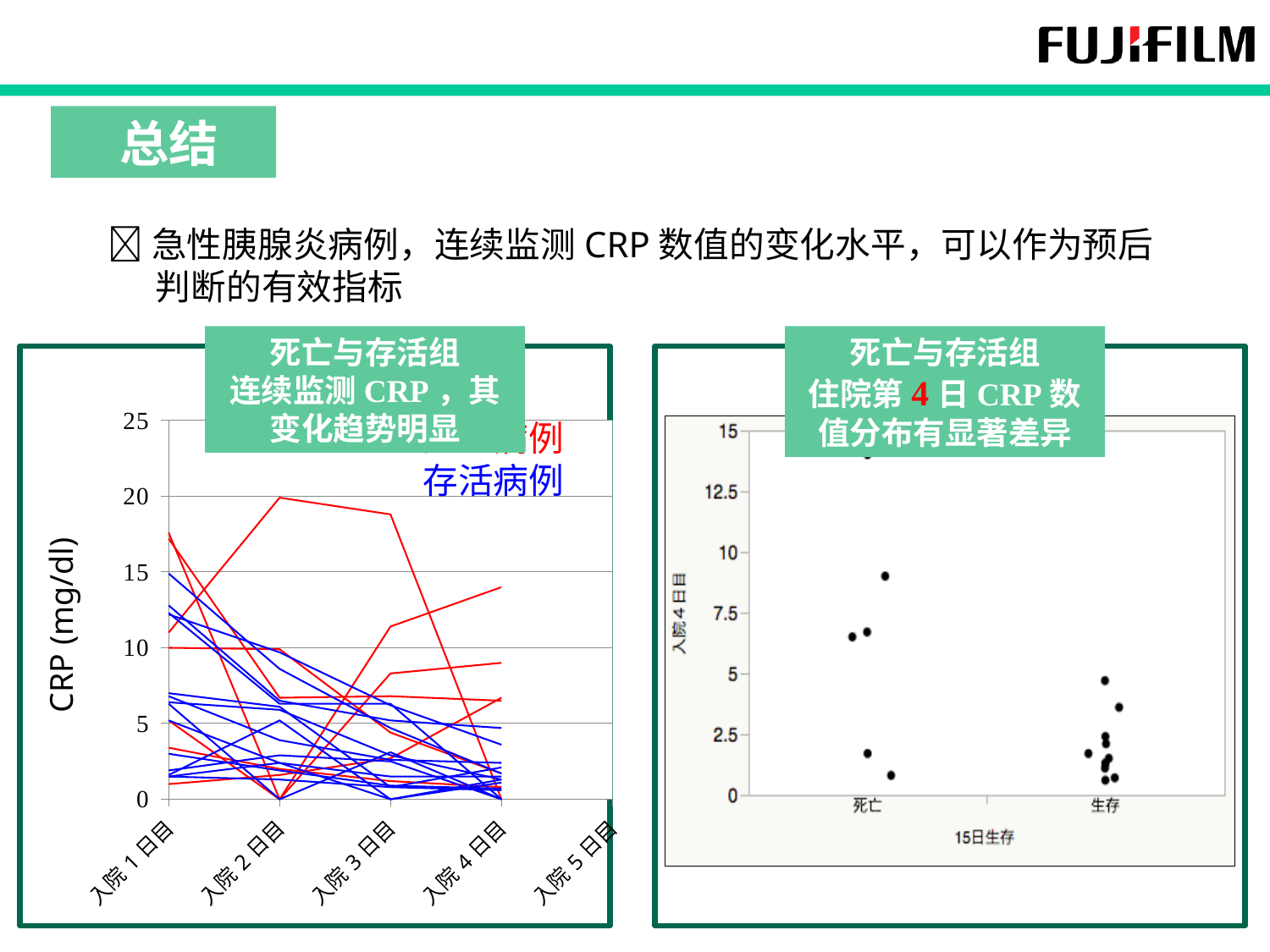
On the right chart, is the highest point in the 死亡 group greater or less than 12.5? greater On the left chart, is the highest red line value at 入院3日目 greater or less than 15? greater On the left chart, how many time points (入院日目) are shown on the x axis? 5 On the right chart, what is the label of the x axis? 15日生存 What kind of chart is the left chart (死亡与存活组 连续监测CRP)? line chart On the right chart, how many groups are shown on the x axis? 2 On the left chart, what is the label of the y axis? CRP (mg/dl) On the left chart, is the highest blue line value at 入院4日目 greater or less than 10? less On the left chart, do the blue (存活病例) lines generally rise or fall from 入院1日目 to 入院4日目? fall On the left chart, which group do the red lines represent? 死亡病例 On the right chart, which group contains the highest plotted point, 死亡 or 生存? 死亡 What kind of chart is the right chart (住院第4日 CRP 数值分布)? scatter plot